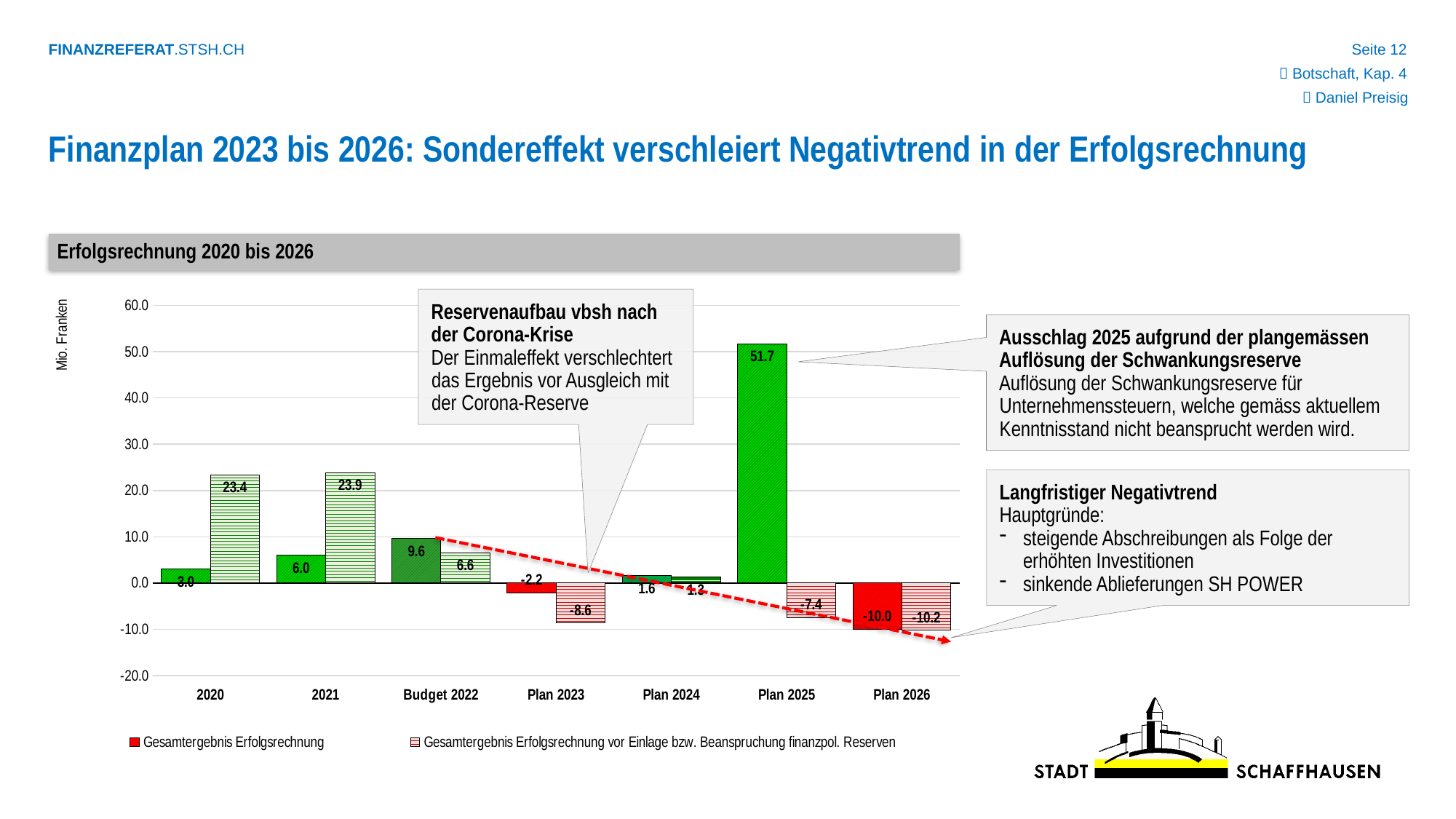
What is the value of 'Gesamtergebnis Erfolgsrechnung' for Plan 2026? -10.0 What unit is shown on the y axis of the chart? Mio. Franken Which is larger for 2020: 'Gesamtergebnis Erfolgsrechnung' or 'Gesamtergebnis Erfolgsrechnung vor Einlage bzw. Beanspruchung finanzpol. Reserven'? Gesamtergebnis Erfolgsrechnung vor Einlage bzw. Beanspruchung finanzpol. Reserven How many categories are shown on the x axis of the chart? 7 How many series does the legend of the chart list? 2 What kind of chart is shown under the heading 'Erfolgsrechnung 2020 bis 2026'? bar chart What is the value of 'Gesamtergebnis Erfolgsrechnung' for Plan 2025? 51.7 Which category has the lowest value for 'Gesamtergebnis Erfolgsrechnung vor Einlage bzw. Beanspruchung finanzpol. Reserven'? Plan 2026 What is the difference between the 'Gesamtergebnis Erfolgsrechnung' values for Budget 2022 and 2021? 3.6 What is the value of 'Gesamtergebnis Erfolgsrechnung vor Einlage bzw. Beanspruchung finanzpol. Reserven' for Plan 2023? -8.6 Which category has the highest value for 'Gesamtergebnis Erfolgsrechnung'? Plan 2025 What is the value of 'Gesamtergebnis Erfolgsrechnung vor Einlage bzw. Beanspruchung finanzpol. Reserven' for 2021? 23.9